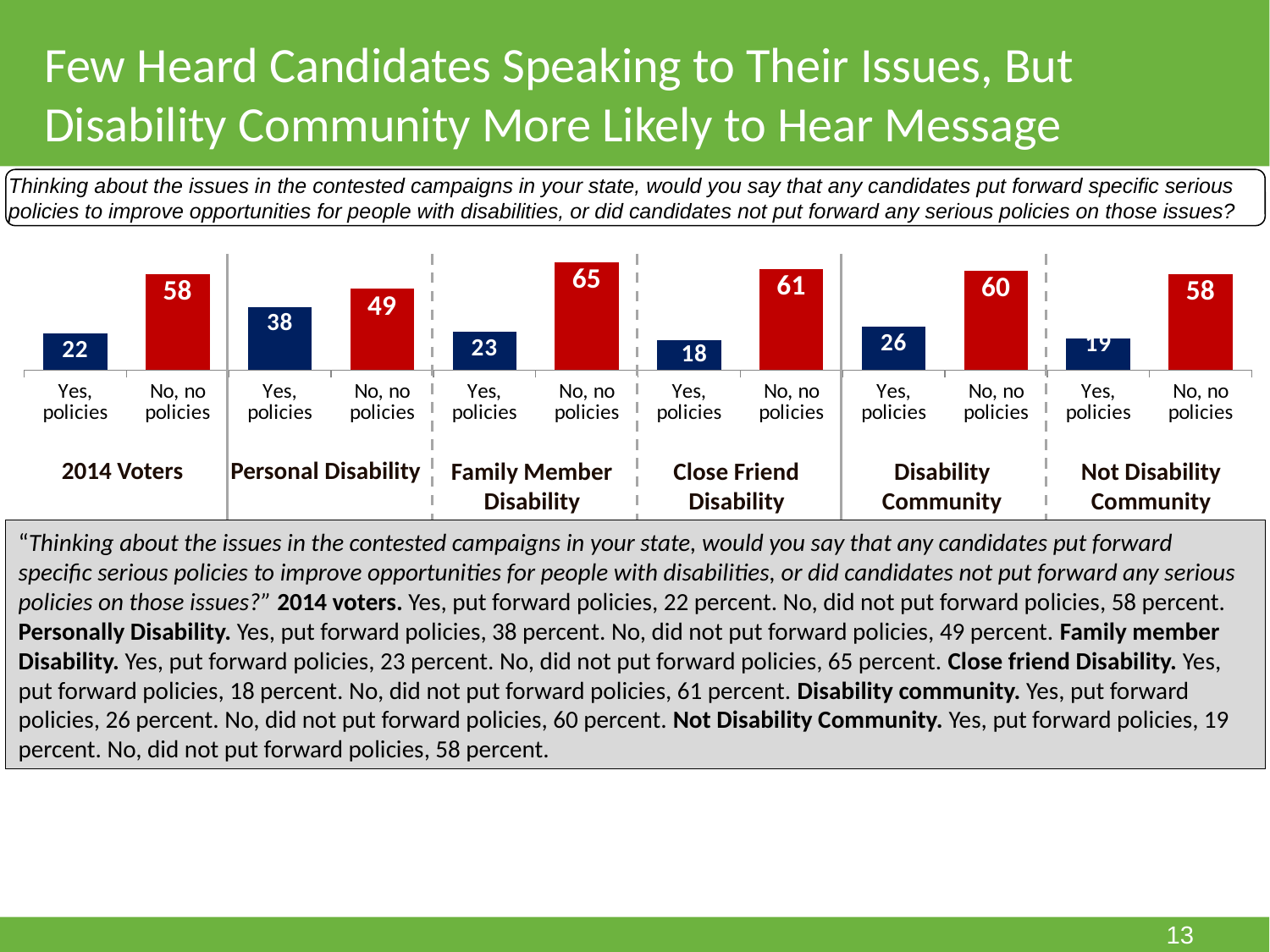
Which group has the highest "Yes, policies" value? Personal Disability How many groups are shown in the chart? 6 What is the difference between "No, no policies" and "Yes, policies" in the Disability Community group? 34 What is the value for "Yes, policies" in the 2014 Voters group? 22 What is the value for "Yes, policies" in the Personal Disability group? 38 Which is larger: "Yes, policies" for Disability Community or "Yes, policies" for Not Disability Community? Disability Community Which group has the lowest "Yes, policies" value? Close Friend Disability What is the value for "No, no policies" in the Family Member Disability group? 65 What is the value for "No, no policies" in the Not Disability Community group? 58 Which group has the highest "No, no policies" value? Family Member Disability What type of chart is shown on the slide? Bar chart What is the difference between "No, no policies" and "Yes, policies" in the Personal Disability group? 11